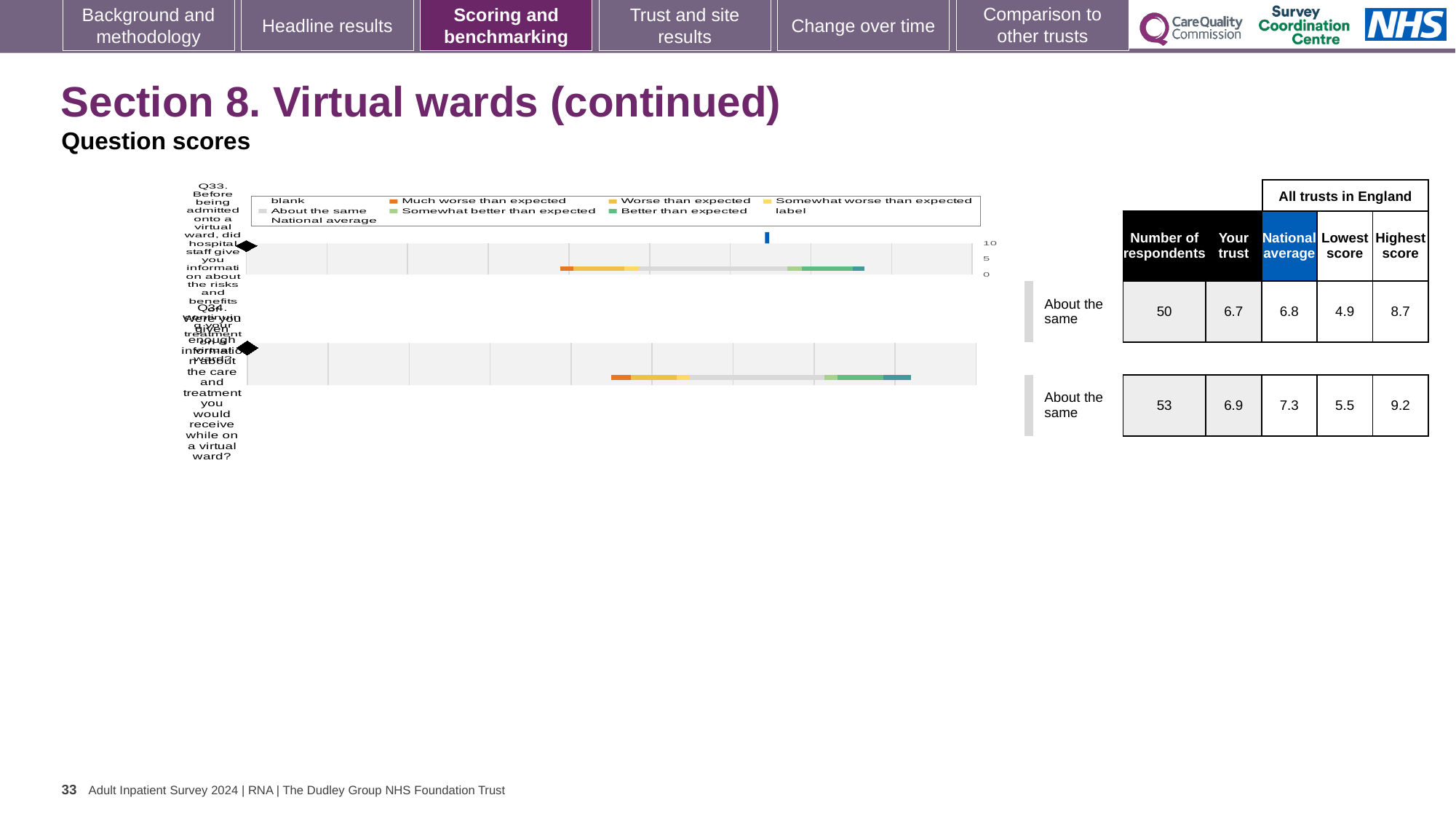
What benchmark category is shown for Q33? About the same What kind of chart is used to show the question scores for Q33 and Q34? bar chart What is the national average score for Q33? 6.8 What is the difference between the highest and lowest scores for Q34? 3.7 What is the highest score among all trusts in England for Q33? 8.7 How many questions (categories) are plotted in the chart? 2 What is the 'Your trust' score for Q33 (information about the risks and benefits of a virtual ward)? 6.7 What is the 'Your trust' score for Q34 (enough information about the care and treatment on a virtual ward)? 6.9 Which question has the higher 'Your trust' score, Q33 or Q34? Q34 By how much does the national average for Q33 exceed the trust's score for Q33? 0.1 How many respondents answered Q34? 53 What is the lowest score among all trusts in England for Q34? 5.5